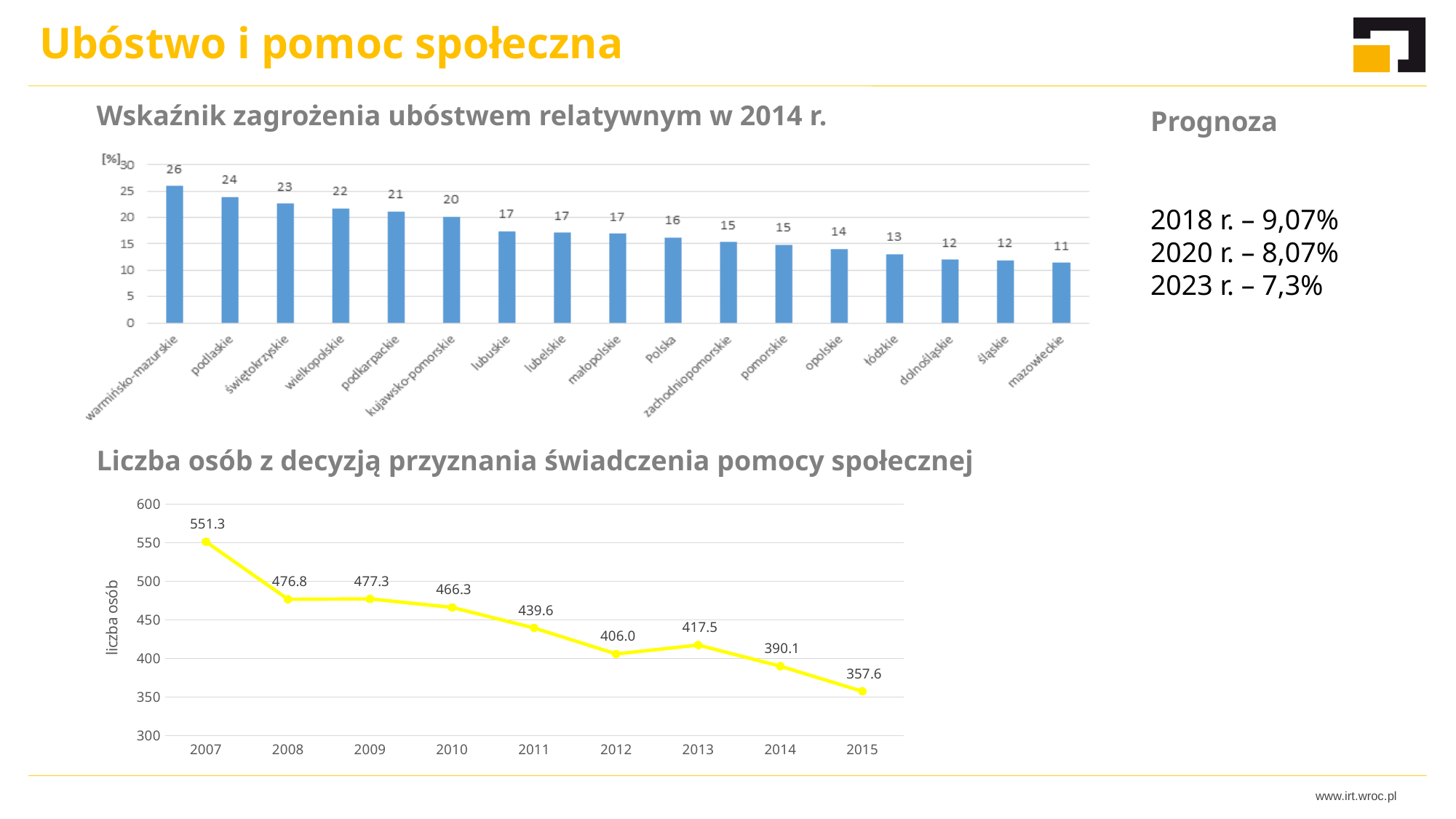
In the top chart 'Wskaźnik zagrożenia ubóstwem relatywnym w 2014 r.', which region has the lowest value? mazowieckie In the bottom chart 'Liczba osób z decyzją przyznania świadczenia pomocy społecznej', which is larger, the value for 2012 or 2013? 2013 In the bottom chart 'Liczba osób z decyzją przyznania świadczenia pomocy społecznej', what is the value for 2007? 551.3 In the top chart 'Wskaźnik zagrożenia ubóstwem relatywnym w 2014 r.', how many regions/categories are shown? 17 In the bottom chart 'Liczba osób z decyzją przyznania świadczenia pomocy społecznej', what is the difference between the 2007 and 2008 values? 74.5 In the top chart 'Wskaźnik zagrożenia ubóstwem relatywnym w 2014 r.', which region has the highest value? warmińsko-mazurskie In the top chart 'Wskaźnik zagrożenia ubóstwem relatywnym w 2014 r.', what is the value for dolnośląskie? 12 In the top chart 'Wskaźnik zagrożenia ubóstwem relatywnym w 2014 r.', what is the value for Polska? 16 In the bottom chart 'Liczba osób z decyzją przyznania świadczenia pomocy społecznej', what is the value for 2015? 357.6 In the bottom chart 'Liczba osób z decyzją przyznania świadczenia pomocy społecznej', do the values generally rise or fall from 2007 to 2015? fall In the top chart 'Wskaźnik zagrożenia ubóstwem relatywnym w 2014 r.', what is the difference between warmińsko-mazurskie and mazowieckie? 15 What kind of chart is the top chart 'Wskaźnik zagrożenia ubóstwem relatywnym w 2014 r.'? bar chart